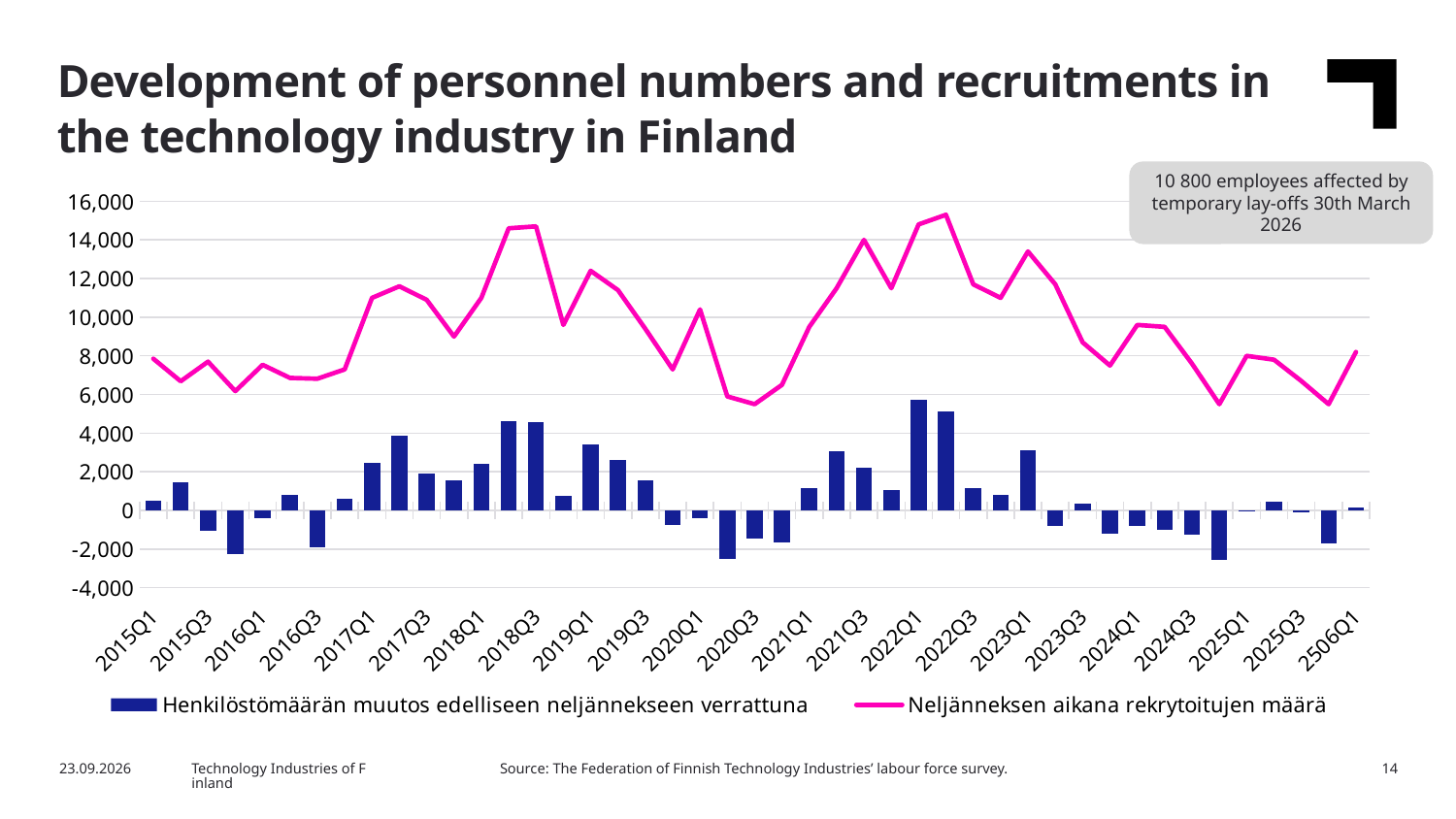
How many series does the legend list? 2 Which series is drawn as a line? Neljänneksen aikana rekrytoitujen määrä In which quarter does the line series (Neljänneksen aikana rekrytoitujen määrä) reach its highest value? 2022Q2 Which bar is larger: 2022Q1 or 2018Q3? 2022Q1 Does the line series generally rise or fall between 2022Q2 and 2025Q3? fall Is the bar value for 2022Q1 greater or less than 4,000? greater Which is larger for the line series: the value at 2018Q3 or the value at 2015Q1? 2018Q3 What kind of chart is shown on the slide? A combined bar and line chart Is the value of the line series at 2020Q3 greater or less than 6,000? less Is the value of the line series at 2018Q3 greater or less than 14,000? greater What is the title of the chart? Development of personnel numbers and recruitments in the technology industry in Finland In which quarter is the bar series (Henkilöstömäärän muutos edelliseen neljännekseen verrattuna) at its highest? 2022Q1